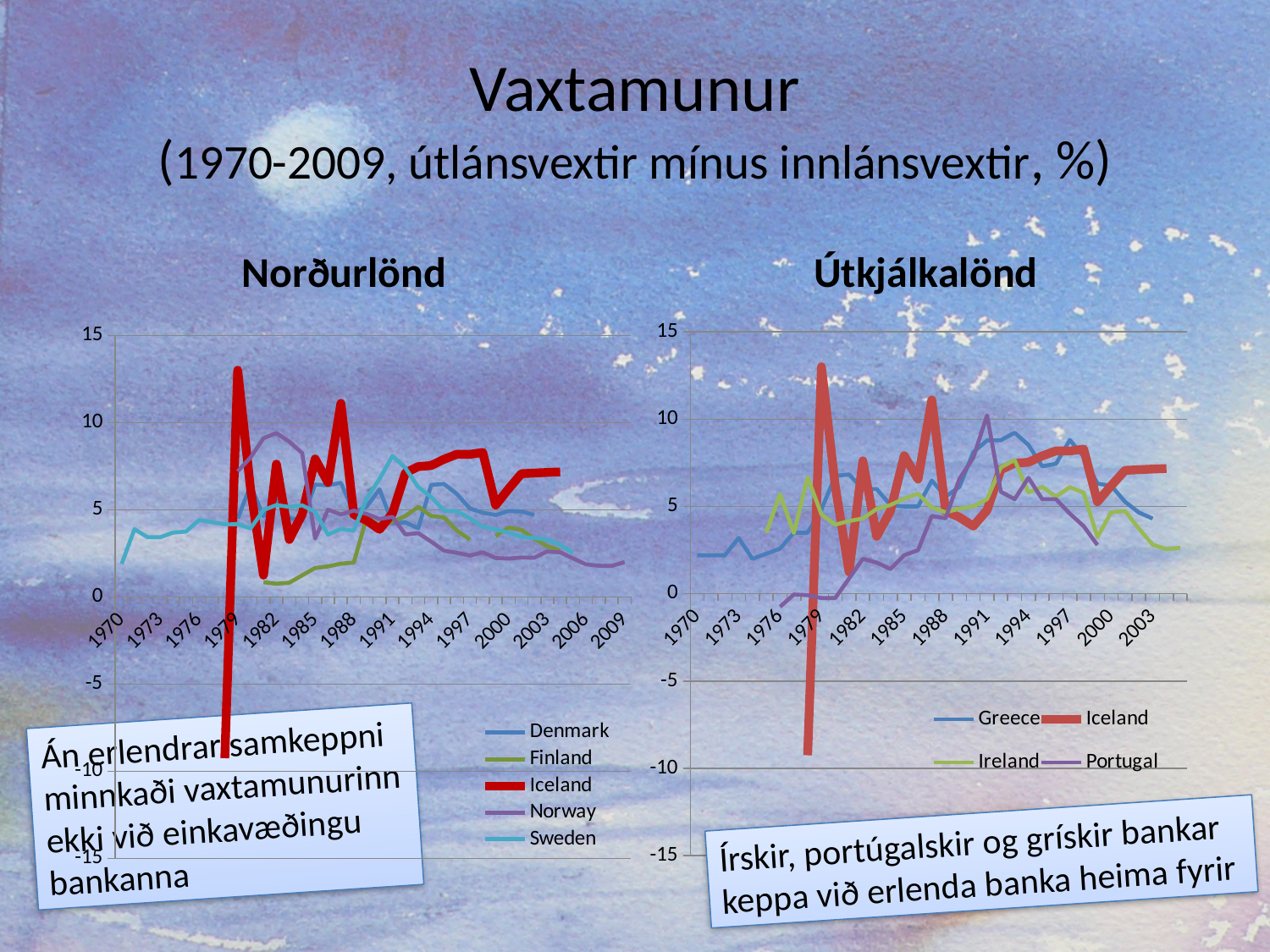
Which countries are listed in the legend of the Útkjálkalönd chart? Greece, Iceland, Ireland, Portugal In the Útkjálkalönd chart, which series reaches the lowest value on the chart? Iceland In the Norðurlönd chart, which series reaches the highest value on the chart? Iceland In the Norðurlönd chart, is the value for Finland in 1982 greater or less than 5? less How many series does the legend of the Útkjálkalönd chart list? 4 Which series is drawn with the thick red line in both charts? Iceland In the Útkjálkalönd chart, is the value for Portugal in 1976 greater or less than 5? less In the Norðurlönd chart, is the peak value for Iceland around 1979 greater or less than 10? greater What kind of chart is the Norðurlönd chart? line chart How many series does the legend of the Norðurlönd chart list? 5